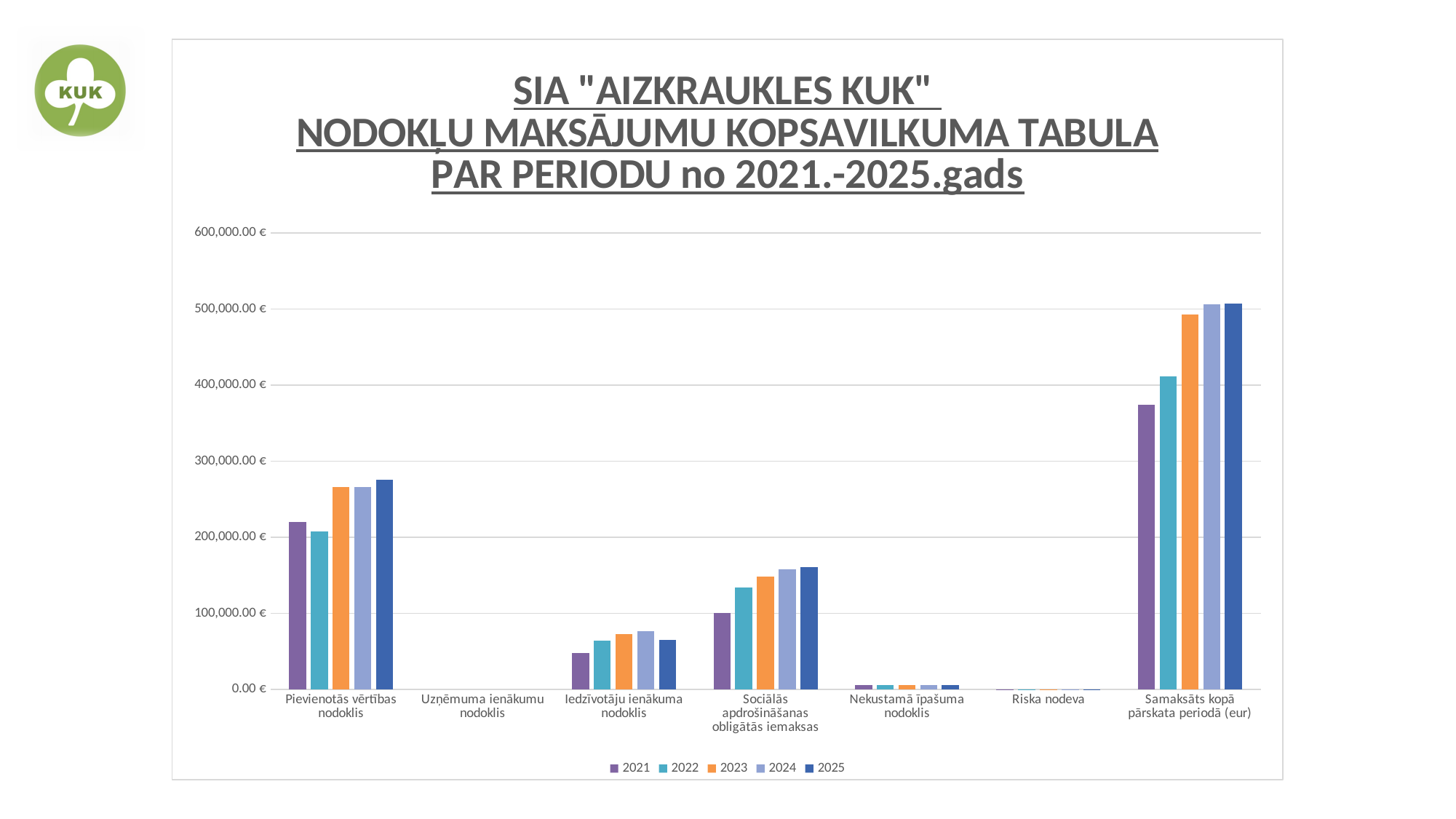
Which company is named in the chart title? SIA "AIZKRAUKLES KUK" For Iedzīvotāju ienākuma nodoklis, which year has the larger value, 2024 or 2025? 2024 Which category has the highest value for 2025? Samaksāts kopā pārskata periodā (eur) How many categories are shown on the x axis? 7 What kind of chart is shown on the slide? bar chart How many series does the legend list? 5 Is the 2022 value for Sociālās apdrošināšanas obligātās iemaksas greater or less than 100,000.00 €? greater For Pievienotās vērtības nodoklis, which year has the larger value, 2021 or 2022? 2021 Is the 2021 value for Samaksāts kopā pārskata periodā (eur) greater or less than 400,000.00 €? less Which years are listed in the legend? 2021, 2022, 2023, 2024, 2025 For Sociālās apdrošināšanas obligātās iemaksas, do the values rise or fall from 2021 to 2025? rise Is the 2025 value for Pievienotās vērtības nodoklis greater or less than 200,000.00 €? greater